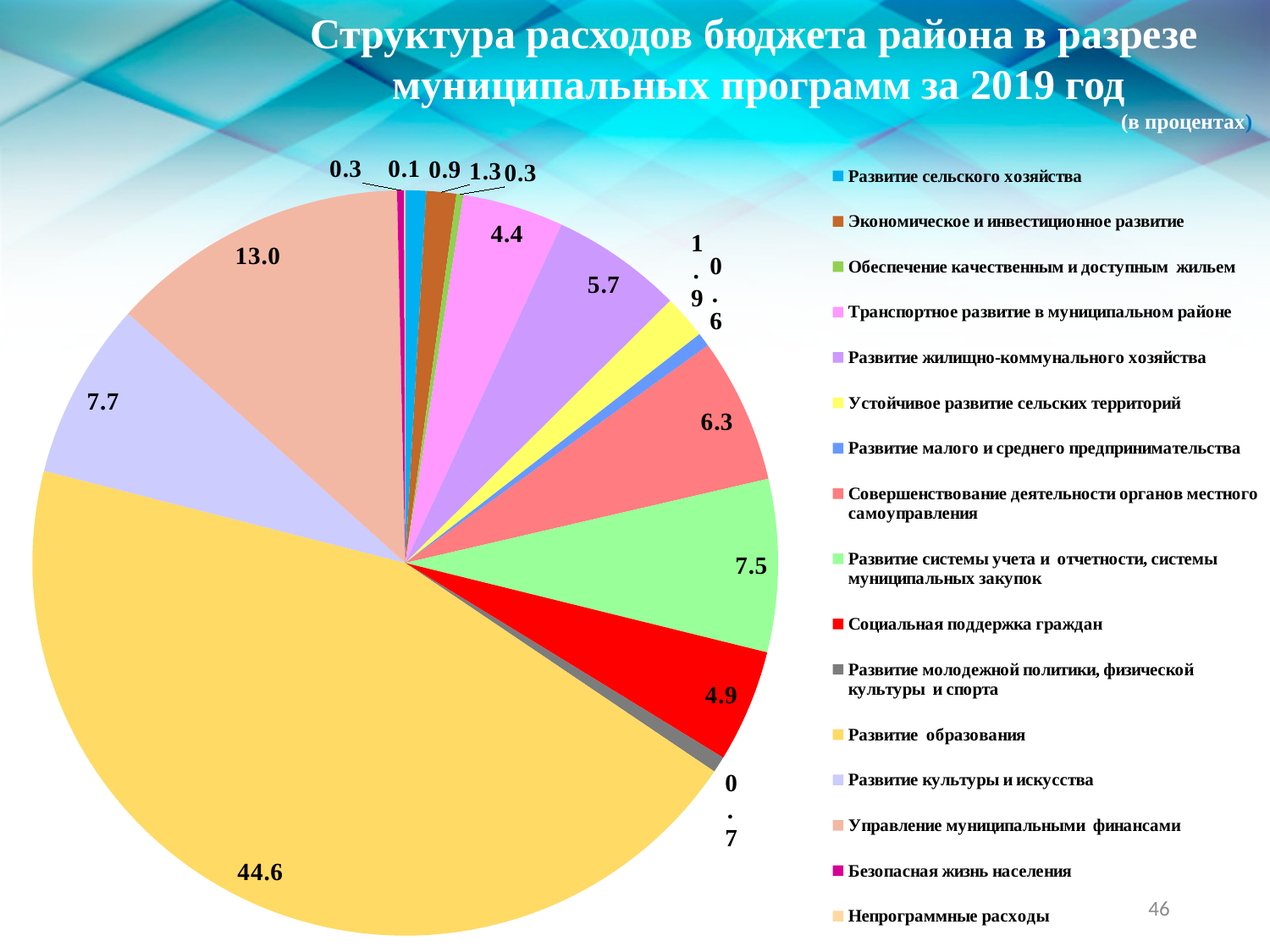
What type of chart is shown on the slide? Pie chart What value is shown for Социальная поддержка граждан? 4.9 What value is shown for Развитие молодежной политики, физической культуры и спорта? 0.7 Which has the larger share: Развитие системы учета и отчетности, системы муниципальных закупок or Совершенствование деятельности органов местного самоуправления? Развитие системы учета и отчетности, системы муниципальных закупок By how many percentage points does Управление муниципальными финансами exceed Развитие культуры и искусства? 5.3 What value is shown for Управление муниципальными финансами? 13.0 What percentage of expenditure is shown for Развитие образования? 44.6 How many entries does the legend of the pie chart list? 16 What value is shown for Транспортное развитие в муниципальном районе? 4.4 What value is shown for Развитие культуры и искусства? 7.7 Which municipal programme has the largest share of district budget expenditure in the pie chart? Развитие образования What value is shown for Развитие жилищно-коммунального хозяйства? 5.7